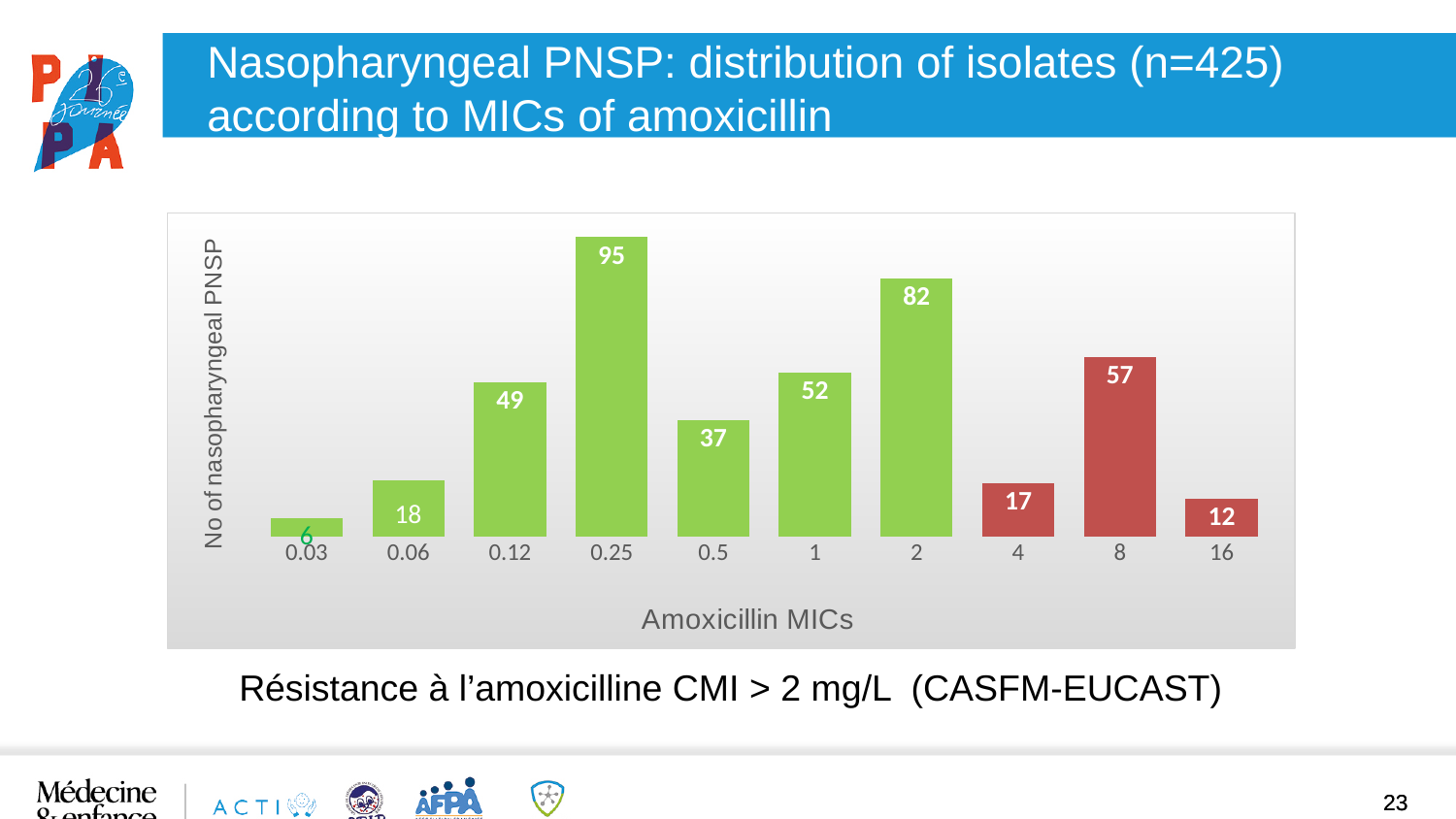
What kind of chart is shown on the slide? Bar chart What is the difference between the number of isolates at MIC 0.25 and at MIC 2? 13 What is the number of nasopharyngeal PNSP isolates at an amoxicillin MIC of 0.25? 95 How many MIC categories are shown on the x axis? 10 What is the number of isolates at an amoxicillin MIC of 0.03? 6 What is the label of the x axis? Amoxicillin MICs What is the difference between the number of isolates at MIC 8 and at MIC 16? 45 What is the total number of isolates in the red bars (MICs 4, 8 and 16)? 86 Which has more isolates: MIC 0.5 or MIC 1? 1 Which amoxicillin MIC has the lowest number of isolates? 0.03 Which amoxicillin MIC has the highest number of isolates? 0.25 What is the number of isolates at an amoxicillin MIC of 8? 57